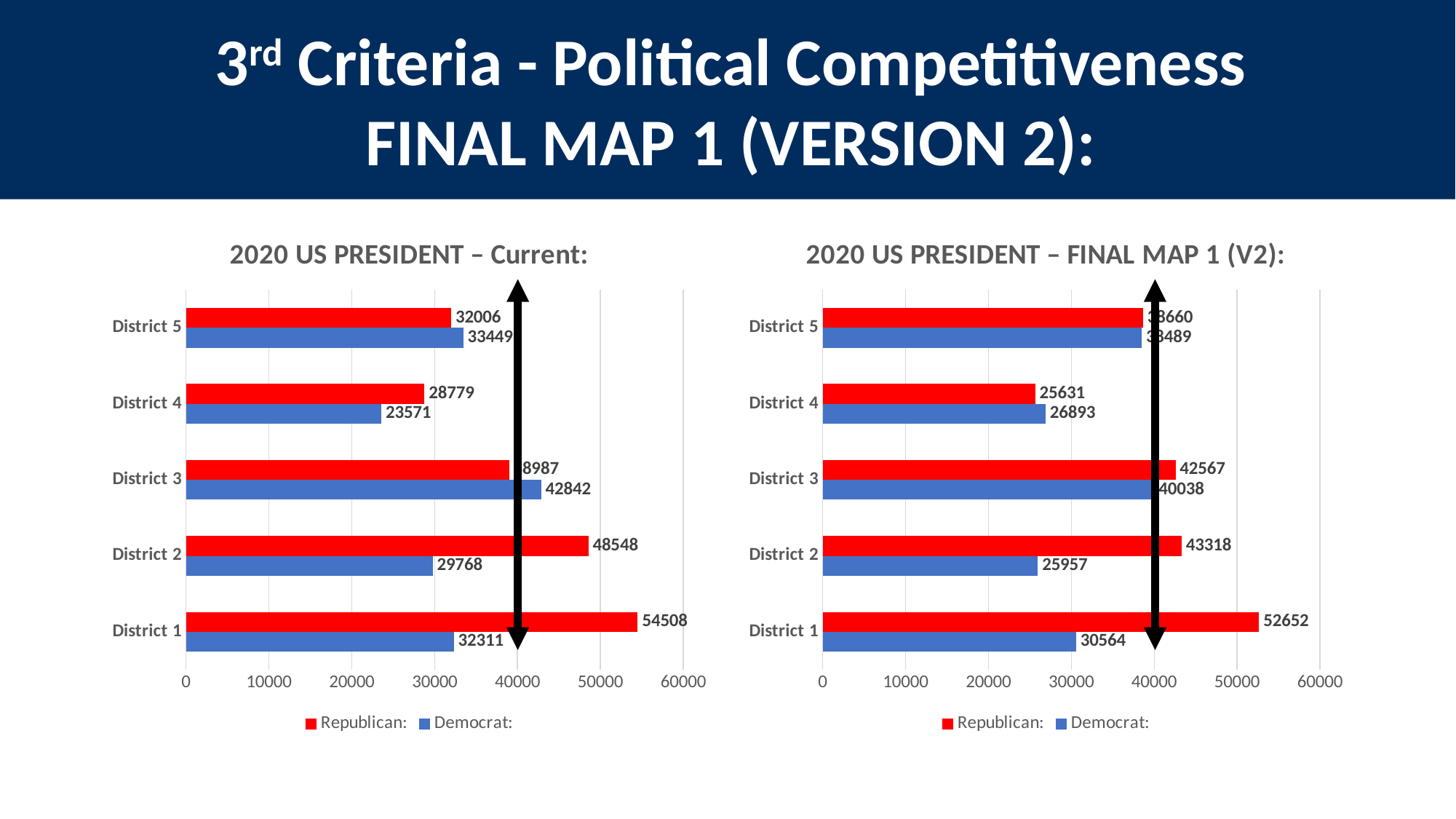
In the '2020 US PRESIDENT – Current:' chart, which district has the highest Republican value? District 1 What type of chart is the '2020 US PRESIDENT – FINAL MAP 1 (V2):' chart? Bar chart How many series does the legend of the '2020 US PRESIDENT – Current:' chart list? 2 In the '2020 US PRESIDENT – Current:' chart, what is the Democrat value for District 4? 23571 In the '2020 US PRESIDENT – FINAL MAP 1 (V2):' chart, which district has the lowest Democrat value? District 2 In the '2020 US PRESIDENT – FINAL MAP 1 (V2):' chart, what is the Democrat value for District 3? 40038 In the '2020 US PRESIDENT – FINAL MAP 1 (V2):' chart, which is larger for District 4, the Republican or the Democrat value? Democrat How many districts are shown in the '2020 US PRESIDENT – FINAL MAP 1 (V2):' chart? 5 In the '2020 US PRESIDENT – Current:' chart, what is the difference between the Republican and Democrat values for District 2? 18780 In the '2020 US PRESIDENT – FINAL MAP 1 (V2):' chart, what is the Republican value for District 2? 43318 In the '2020 US PRESIDENT – Current:' chart, is the Republican value for District 3 greater or less than 30000? greater In the '2020 US PRESIDENT – Current:' chart, what is the Republican value for District 1? 54508